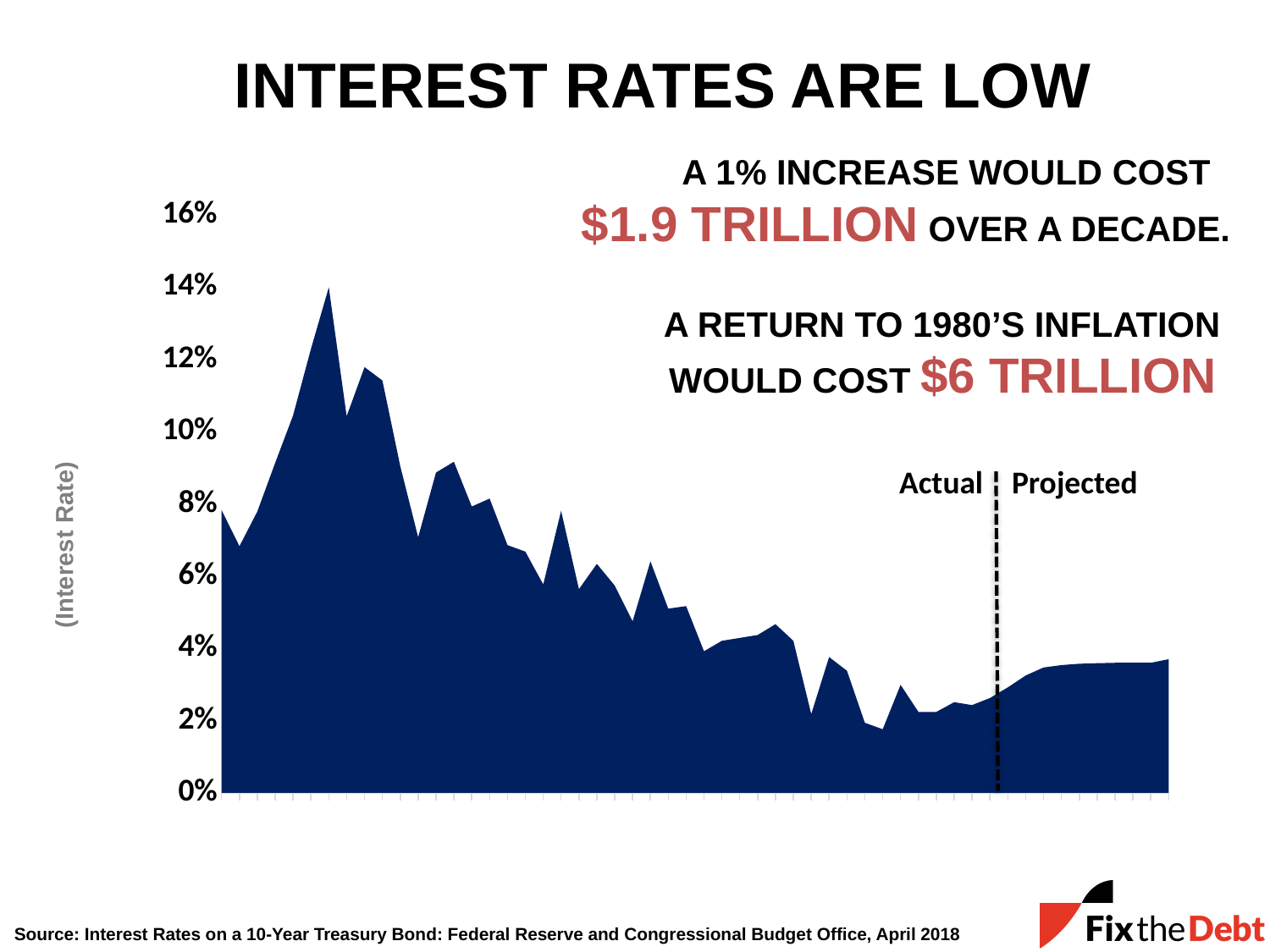
Is the value at the far right end of the chart greater or less than 2%? greater What kind of chart is shown on the slide? area chart Are the values in the Projected portion of the chart greater or less than 4%? less Is the value at the far left of the chart greater or less than 6%? greater After reaching its peak, do the interest rate values generally rise or fall moving to the right along the x axis? fall What two labels appear on either side of the dashed vertical line in the chart? Actual and Projected What is the title of the chart on the slide? INTEREST RATES ARE LOW